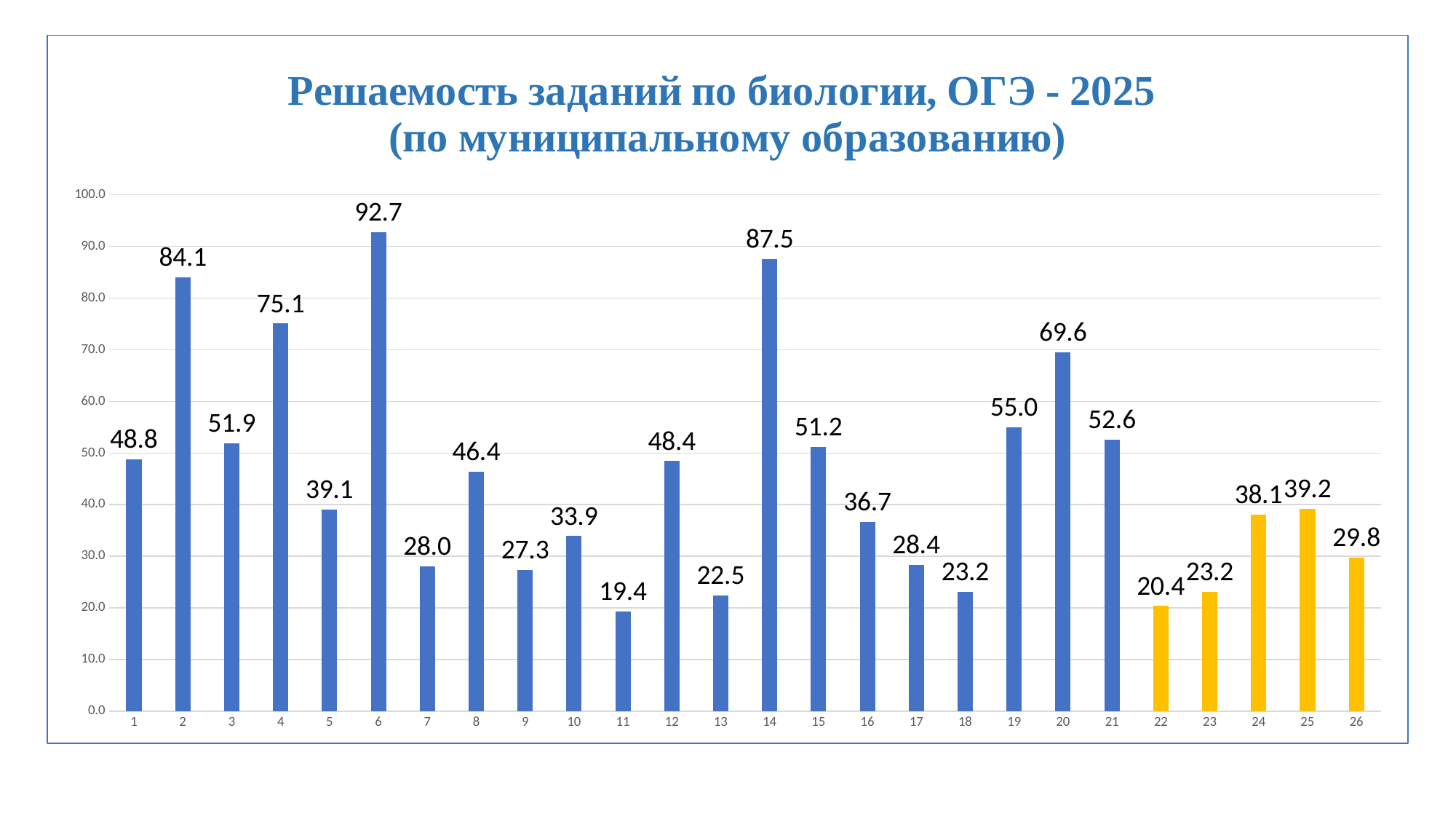
How many bars are coloured yellow instead of blue? 5 What is the value for task 22? 20.4 How many tasks (bars) are shown on the chart? 26 Which has a larger value, task 20 or task 4? task 4 What is the difference between the values for task 6 and task 14? 5.2 What is the value for task 14? 87.5 Which has a larger value, task 19 or task 21? task 19 What is the difference between the values for task 2 and task 4? 9.0 Which task has the highest value? 6 What kind of chart is shown on the slide? bar chart What is the value for task 6? 92.7 Which task has the lowest value? 11